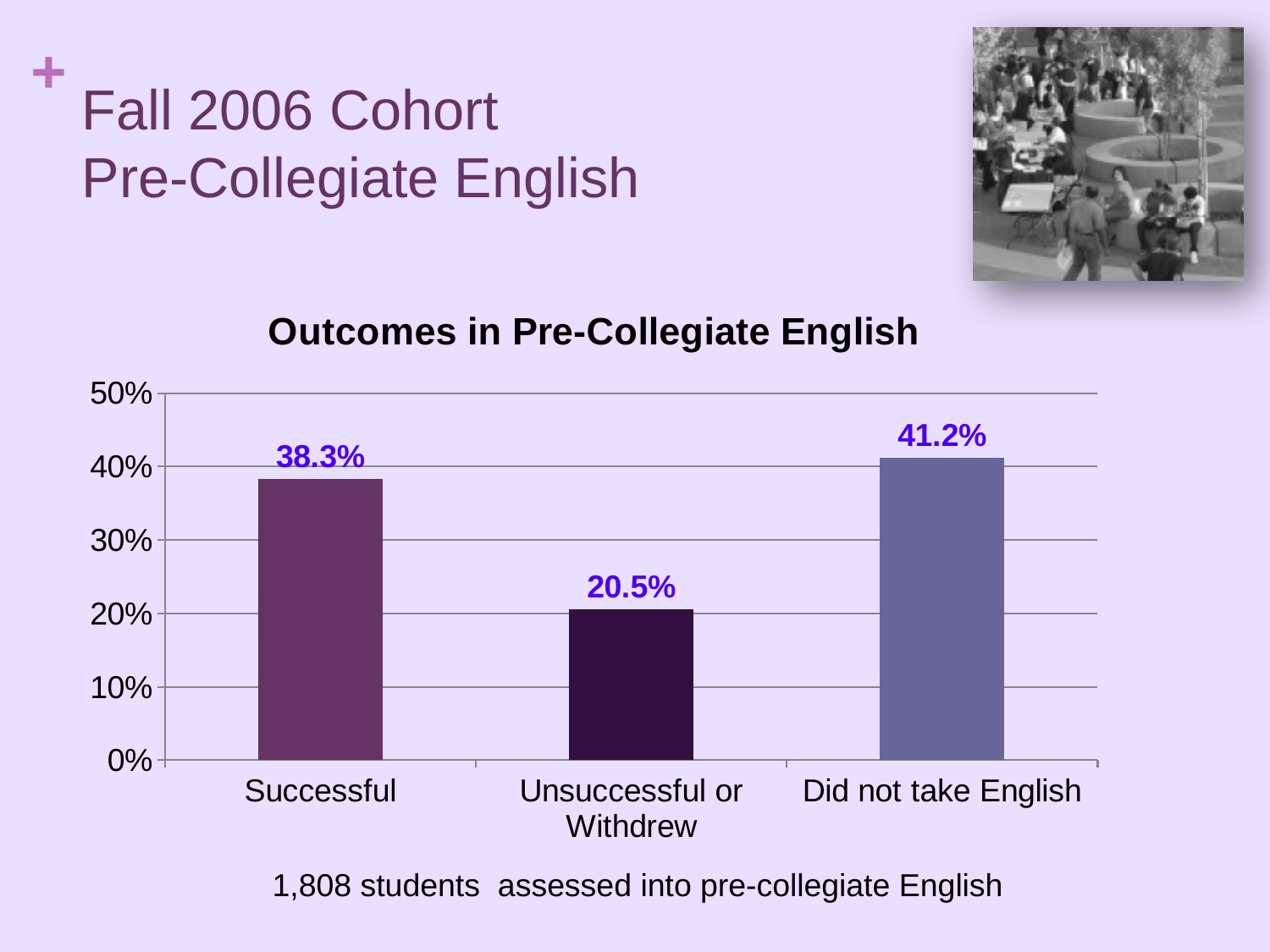
Which category has the lowest value? Unsuccessful or Withdrew What is the value for Unsuccessful or Withdrew? 20.5% Which is larger, the value for Successful or the value for Unsuccessful or Withdrew? Successful What kind of chart is shown on the slide? bar chart Which category has the highest value? Did not take English What is the value for Did not take English? 41.2% What is the difference between the values for Did not take English and Successful? 2.9% Is the value for Unsuccessful or Withdrew greater or less than 30%? less How many categories are shown on the x axis? 3 What is the difference between the values for Successful and Unsuccessful or Withdrew? 17.8% What is the value for Successful? 38.3% What is the title of the chart? Outcomes in Pre-Collegiate English